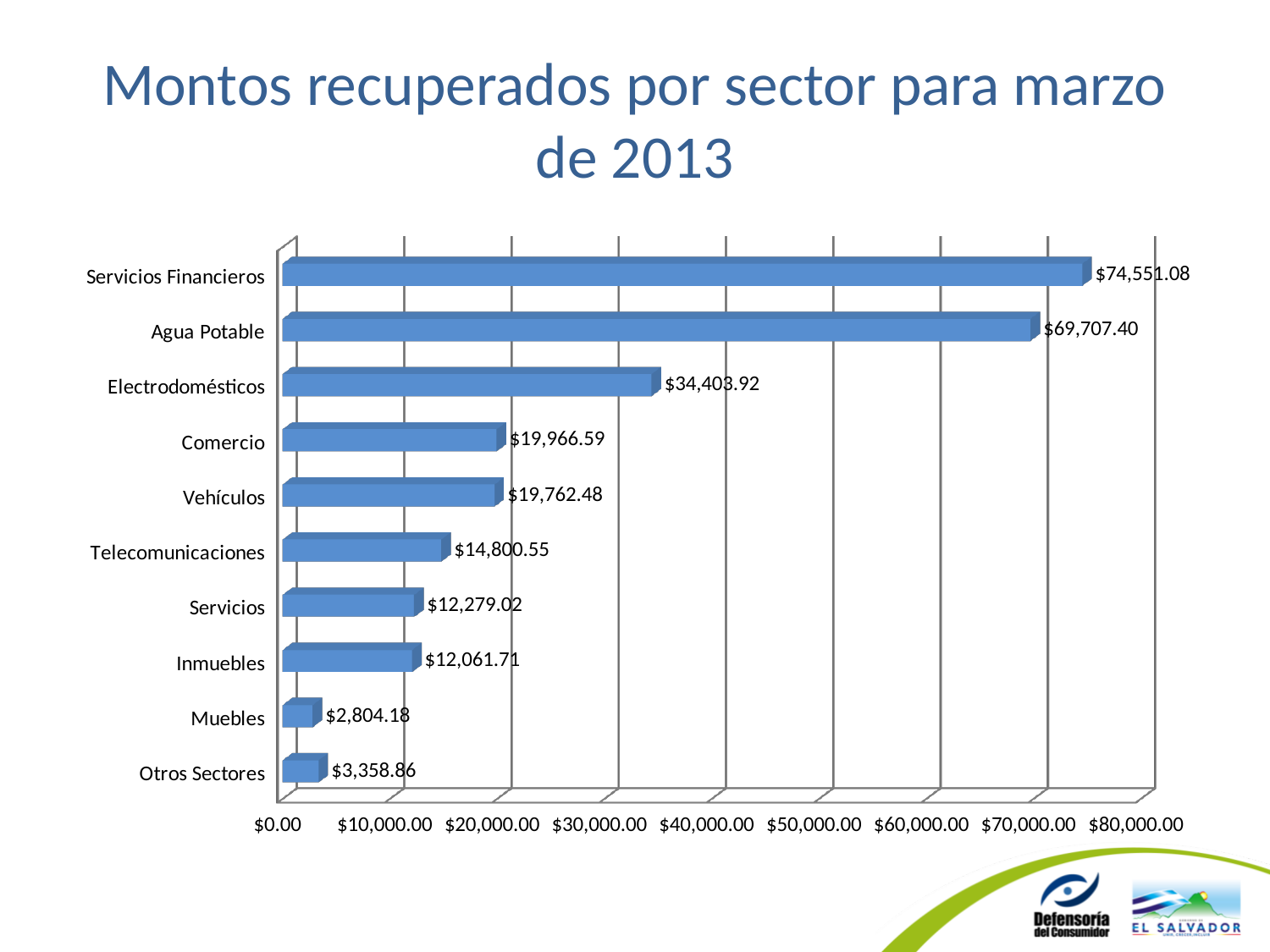
What is the value for Inmuebles? $12,061.71 Which is larger, the value for Comercio or the value for Vehículos? Comercio What kind of chart is shown on the slide? Bar chart Is the value for Electrodomésticos greater or less than $30,000.00? greater What is the value for Telecomunicaciones? $14,800.55 Which sector has the highest recovered amount? Servicios Financieros How many sectors are shown in the chart? 10 Which sector has the lowest recovered amount? Muebles What is the value for Agua Potable? $69,707.40 What is the value for Servicios Financieros? $74,551.08 What is the difference between the values for Otros Sectores and Muebles? $554.68 What is the difference between the values for Servicios Financieros and Agua Potable? $4,843.68